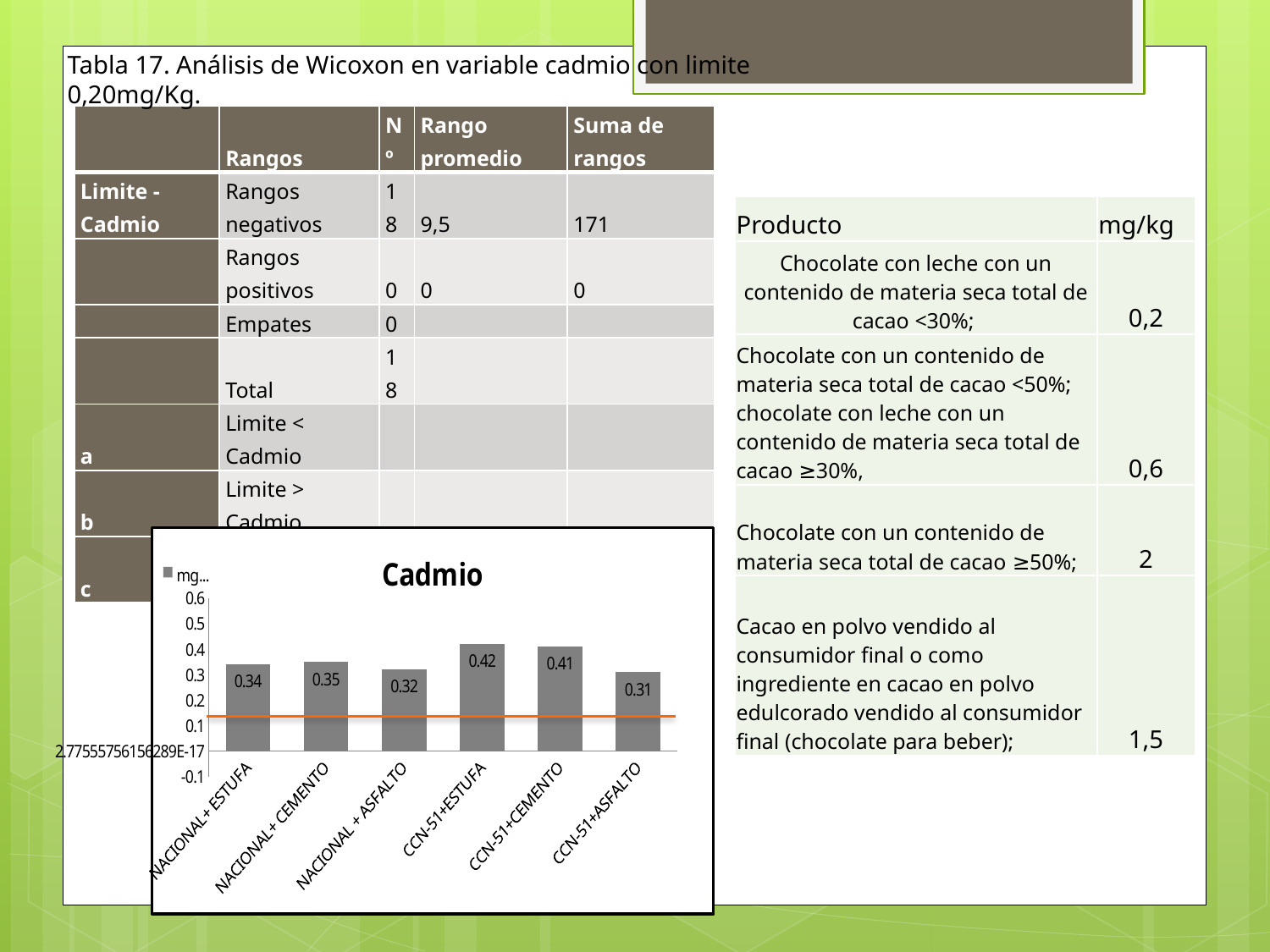
What is the difference between the values for NACIONAL + CEMENTO and NACIONAL + ASFALTO in the 'Cadmio' chart? 0.03 What type of chart is the 'Cadmio' chart? bar chart Which category has the highest value in the 'Cadmio' chart? CCN-51+ESTUFA Which is larger in the 'Cadmio' chart, NACIONAL + CEMENTO or CCN-51+ASFALTO? NACIONAL + CEMENTO How many categories are shown on the x axis of the 'Cadmio' chart? 6 What is the difference between the values for CCN-51+ESTUFA and NACIONAL + ESTUFA in the 'Cadmio' chart? 0.08 Which category has the lowest value in the 'Cadmio' chart? CCN-51+ASFALTO What is the value for CCN-51+CEMENTO in the 'Cadmio' chart? 0.41 Is the value for CCN-51+ESTUFA in the 'Cadmio' chart greater or less than 0.5? less What is the title of the chart? Cadmio What is the value for NACIONAL + ASFALTO in the 'Cadmio' chart? 0.32 What is the value for NACIONAL + ESTUFA in the 'Cadmio' chart? 0.34